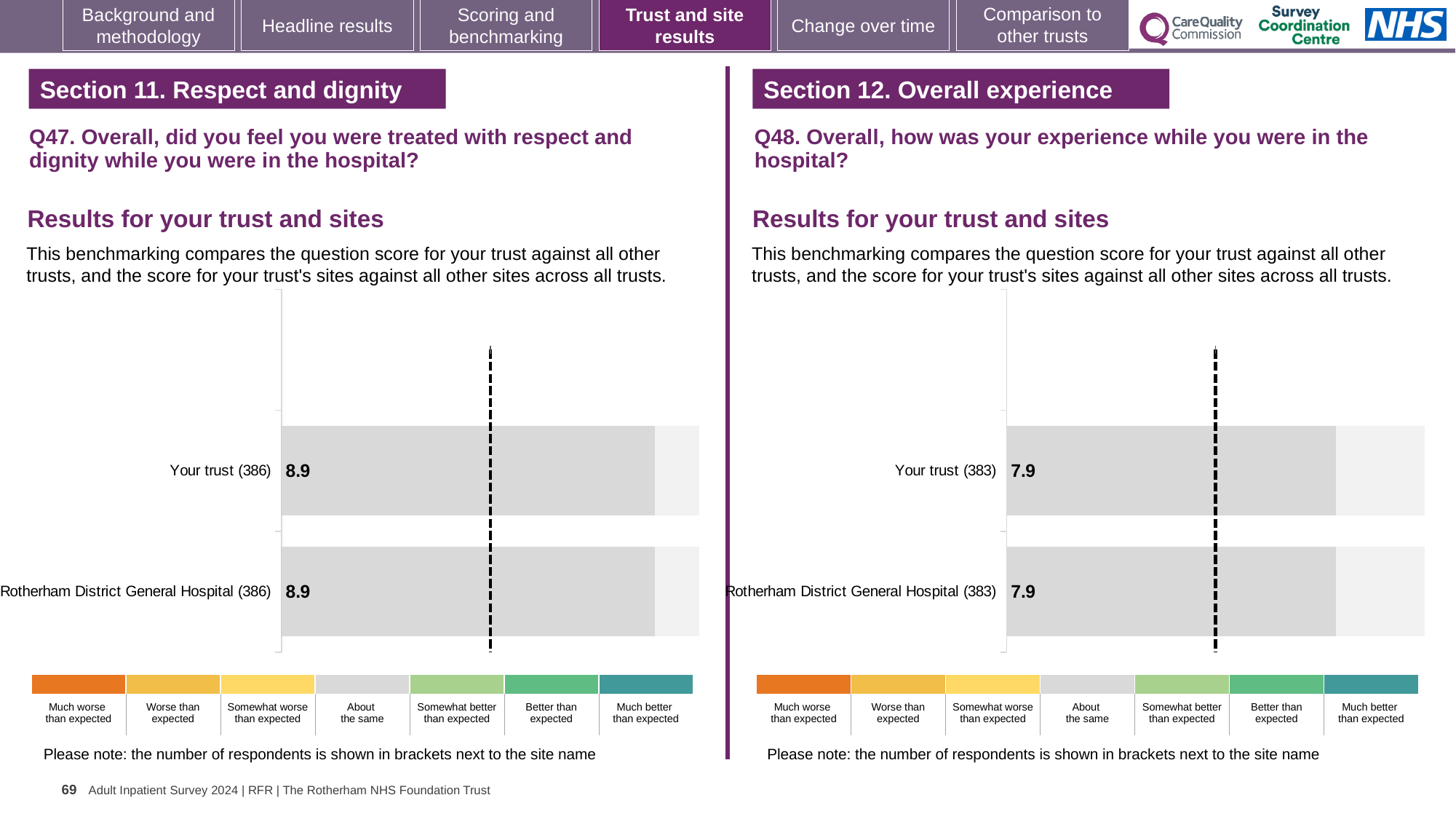
On the Q47 chart (Section 11, left), what is the score for Your trust? 8.9 On the Q48 chart (Section 12, right), what is the score for Rotherham District General Hospital? 7.9 On the Q47 chart (Section 11, left), what is the score for Rotherham District General Hospital? 8.9 How many bars are plotted on the Q47 chart (Section 11, left)? 2 What kind of chart is used on the Q47 chart (Section 11, left)? Bar chart On the Q47 chart (Section 11, left), what is the difference between the score for Your trust and the score for Rotherham District General Hospital? 0 Is the score for Your trust on the Q47 chart (left) larger or smaller than the score for Your trust on the Q48 chart (right)? Larger On the Q48 chart (Section 12, right), what is the score for Your trust? 7.9 How many bars are plotted on the Q48 chart (Section 12, right)? 2 On the Q48 chart (Section 12, right), what is the difference between the score for Your trust and the score for Rotherham District General Hospital? 0 On the Q47 chart (Section 11, left), how many respondents are shown in brackets next to Your trust? 386 On the Q48 chart (Section 12, right), how many respondents are shown in brackets next to Rotherham District General Hospital? 383